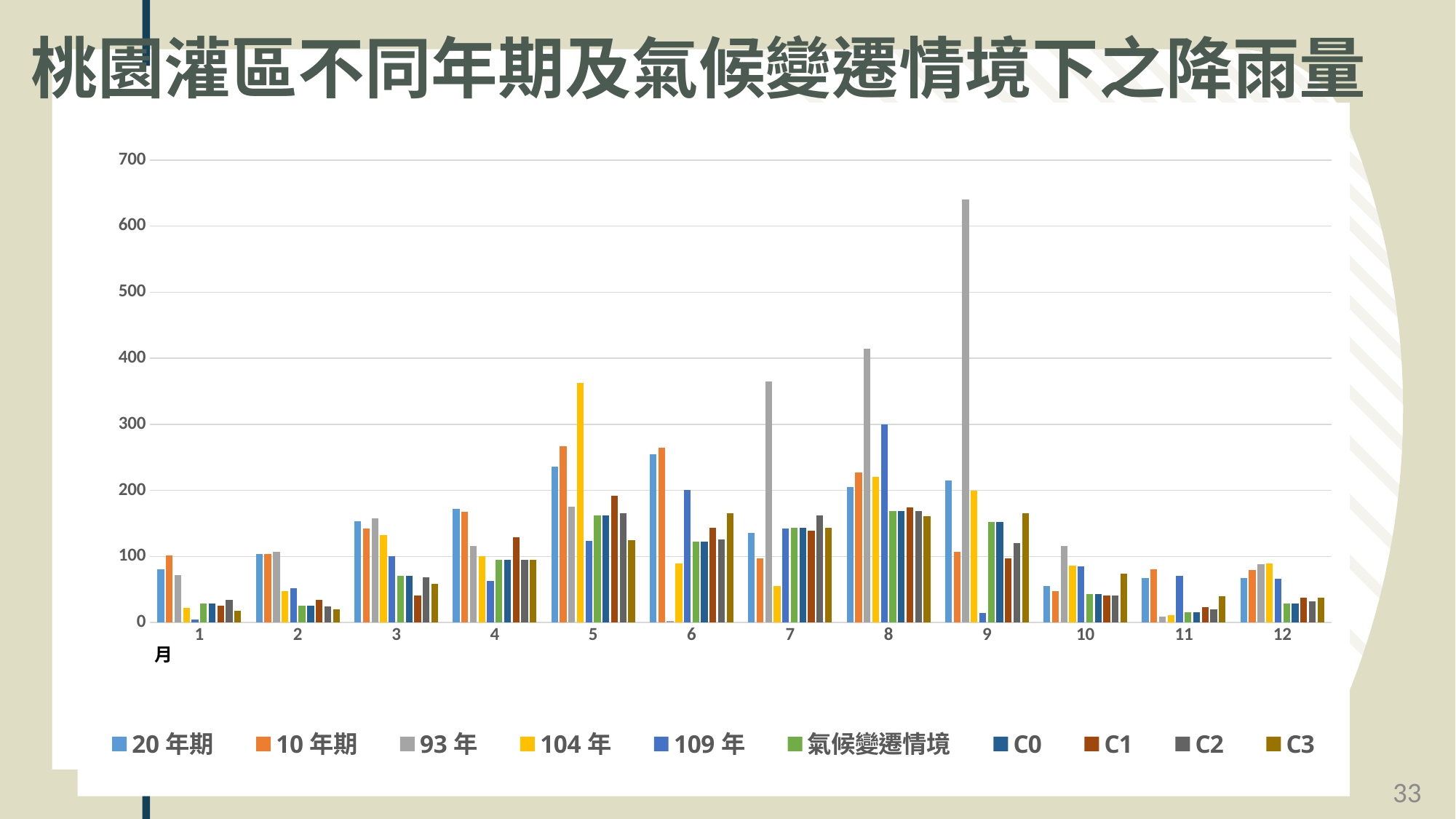
In which month does the 93 年 series reach its highest value? 9 How many categories (months) are shown on the x axis? 12 Is the value for 93 年 in month 8 greater or less than 400? greater Is the value for 93 年 in month 7 greater or less than 400? less Is the value for 93 年 in month 1 greater or less than 100? less What kind of chart is shown on the slide? bar chart Which is larger: the 93 年 value in month 9 or the 93 年 value in month 8? month 9 Which series has the highest value in month 5? 104 年 What is the label shown under the x axis? 月 How many series does the legend list? 10